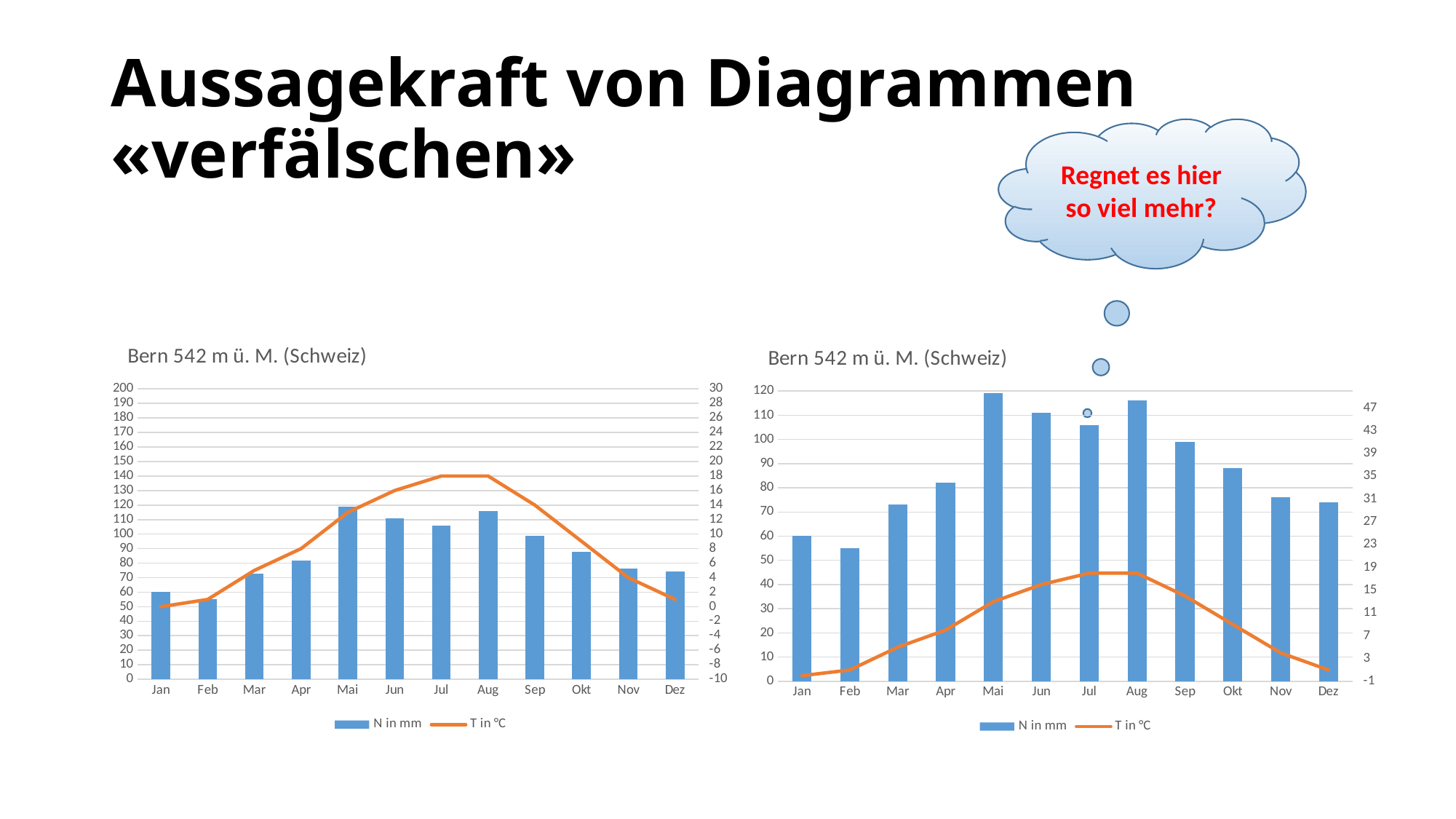
What kind of chart is the chart on the left of the slide? A combined bar and line chart What is the title of the chart on the right? Bern 542 m ü. M. (Schweiz) In the chart on the right, which month has the highest N in mm bar? Mai In the chart on the left, how many months are shown on the x axis? 12 How many series does the legend of the chart on the right list? 2 In the chart on the left, does the T in °C line rise or fall from Jan to Jul? Rise In the chart on the left, which month has the larger N in mm bar, Mai or Jun? Mai In the chart on the right, which month has the larger N in mm bar, Aug or Jul? Aug In the chart on the left, which month has the lowest N in mm bar? Feb In the chart on the right, is the N in mm bar for Mai greater or less than 110? greater